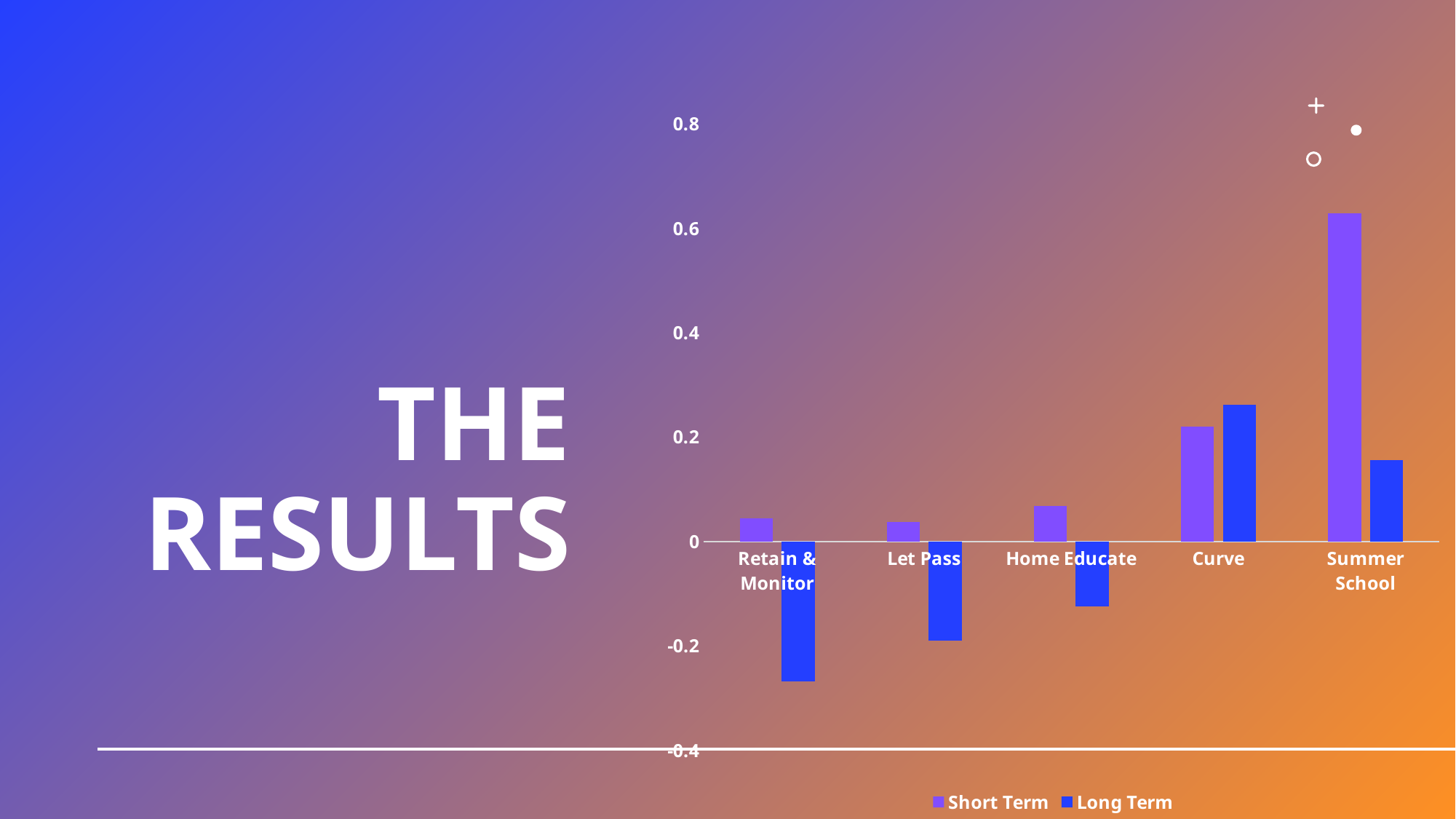
Is the Long Term value for Home Educate greater or less than 0? less Is the Long Term value for Curve greater or less than 0.2? greater How many categories are shown on the x axis of the chart? 5 What are the two series named in the chart's legend? Short Term and Long Term How many series does the chart's legend list? 2 Which category has the lowest Long Term value? Retain & Monitor Is the Long Term value for Retain & Monitor greater or less than -0.2? less What kind of chart is shown on the slide? bar chart Which has the lower Long Term value: Retain & Monitor or Home Educate? Retain & Monitor For Summer School, which is larger: the Short Term value or the Long Term value? Short Term Which category has the highest Short Term value? Summer School